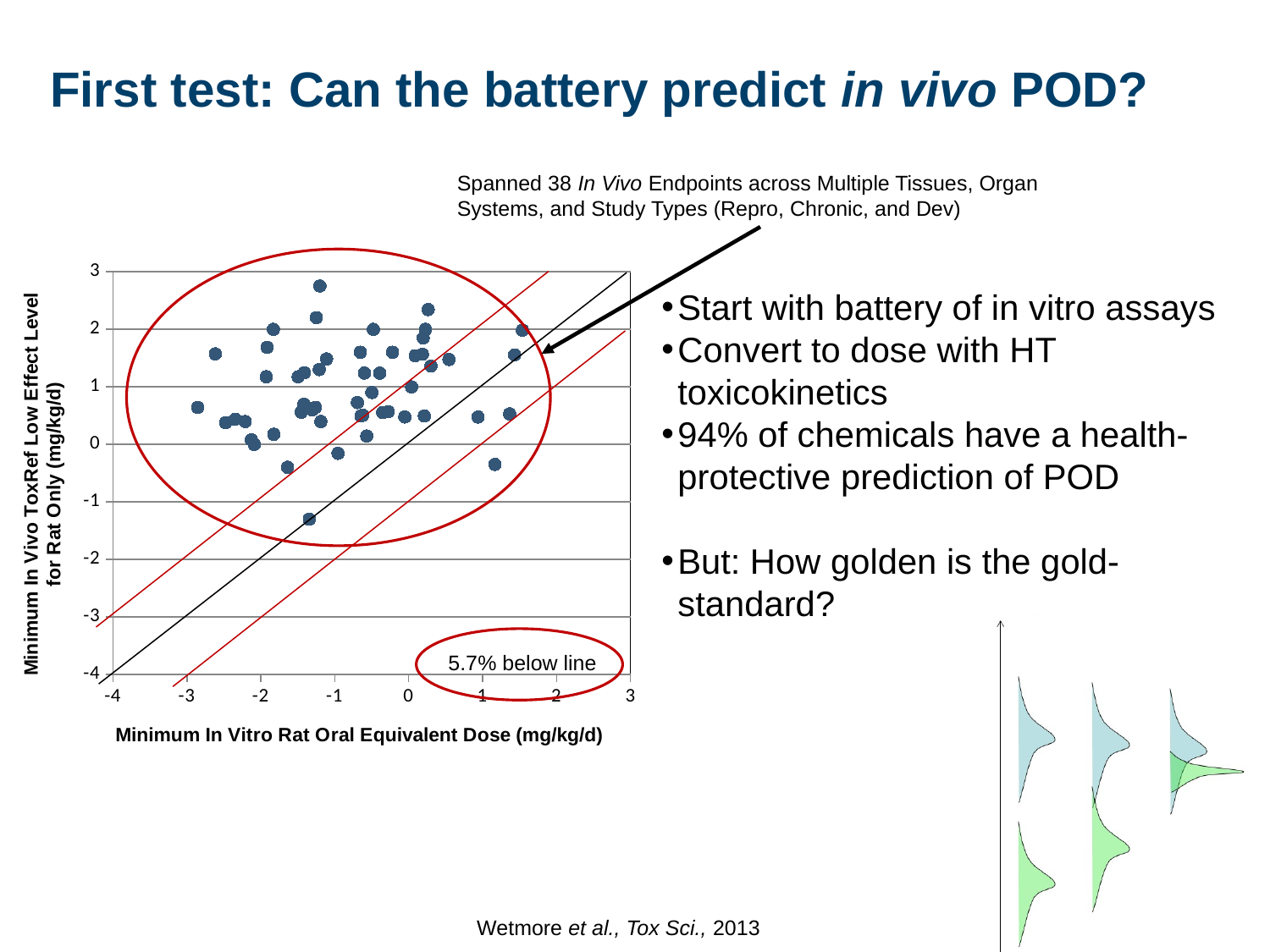
What text is written inside the small red circle at the bottom right of the scatter chart? 5.7% below line What kind of chart is shown on the slide? scatter chart Is the y value of the lowest plotted point greater or less than -1? less Is the x value of the leftmost plotted point greater or less than -3? greater Is the x value of the rightmost plotted point greater or less than 2? less Are most of the plotted points above or below the black diagonal line? above What is the title of the x axis of the scatter chart? Minimum In Vitro Rat Oral Equivalent Dose (mg/kg/d)